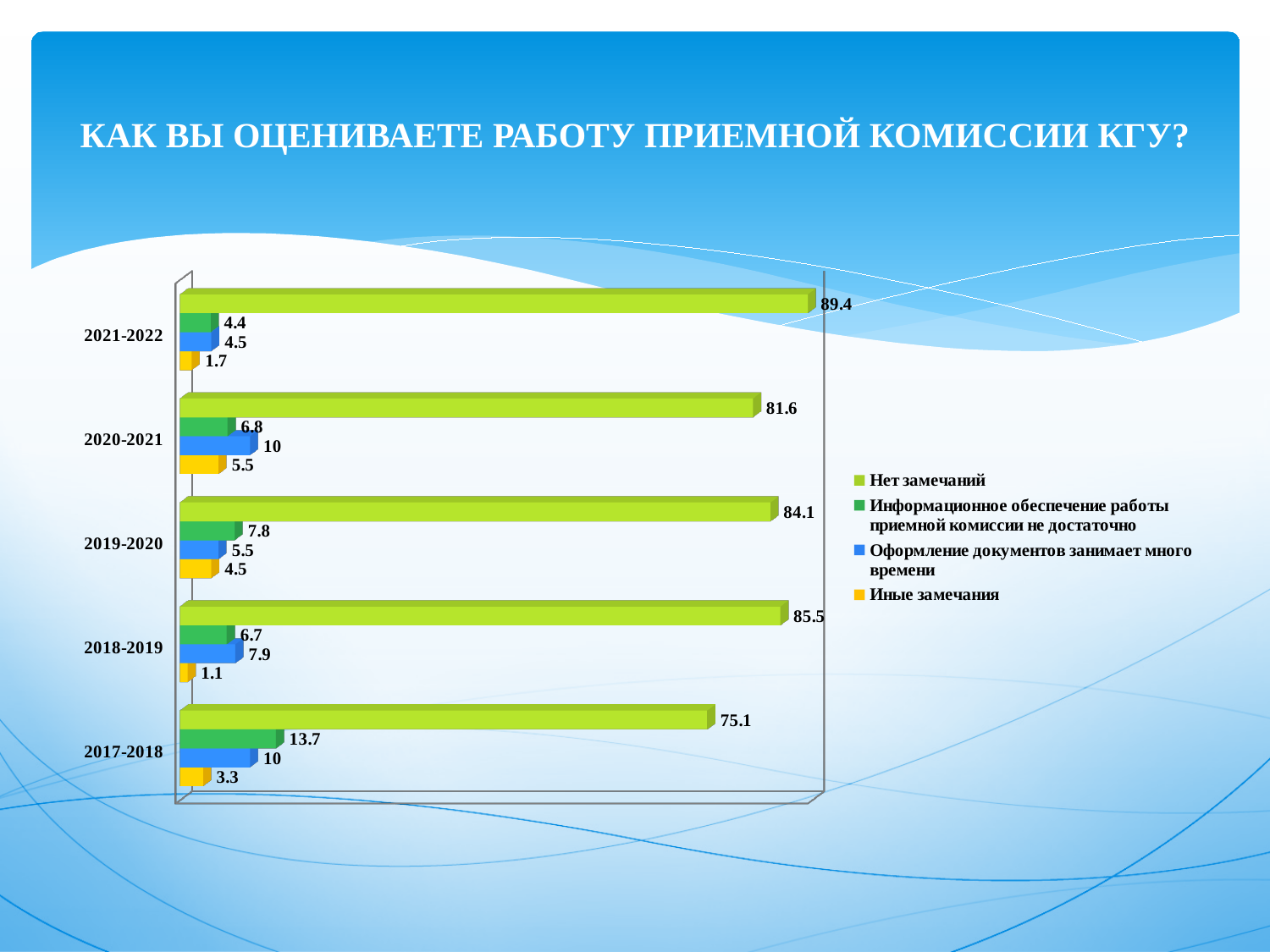
How many academic-year categories are shown on the chart? 5 What is the title of the slide containing the chart? КАК ВЫ ОЦЕНИВАЕТЕ РАБОТУ ПРИЕМНОЙ КОМИССИИ КГУ? What kind of chart is shown on the slide? bar chart In which academic year is the value for "Нет замечаний" the highest? 2021-2022 What is the value for "Информационное обеспечение работы приемной комиссии не достаточно" in 2017-2018? 13.7 What is the value for "Иные замечания" in 2018-2019? 1.1 Which is larger in 2019-2020: "Информационное обеспечение работы приемной комиссии не достаточно" or "Оформление документов занимает много времени"? Информационное обеспечение работы приемной комиссии не достаточно What is the value for "Оформление документов занимает много времени" in 2020-2021? 10 What is the value for "Нет замечаний" in 2021-2022? 89.4 In which academic year is the value for "Нет замечаний" the lowest? 2017-2018 What is the difference between the "Нет замечаний" values for 2021-2022 and 2017-2018? 14.3 How many series does the legend list? 4